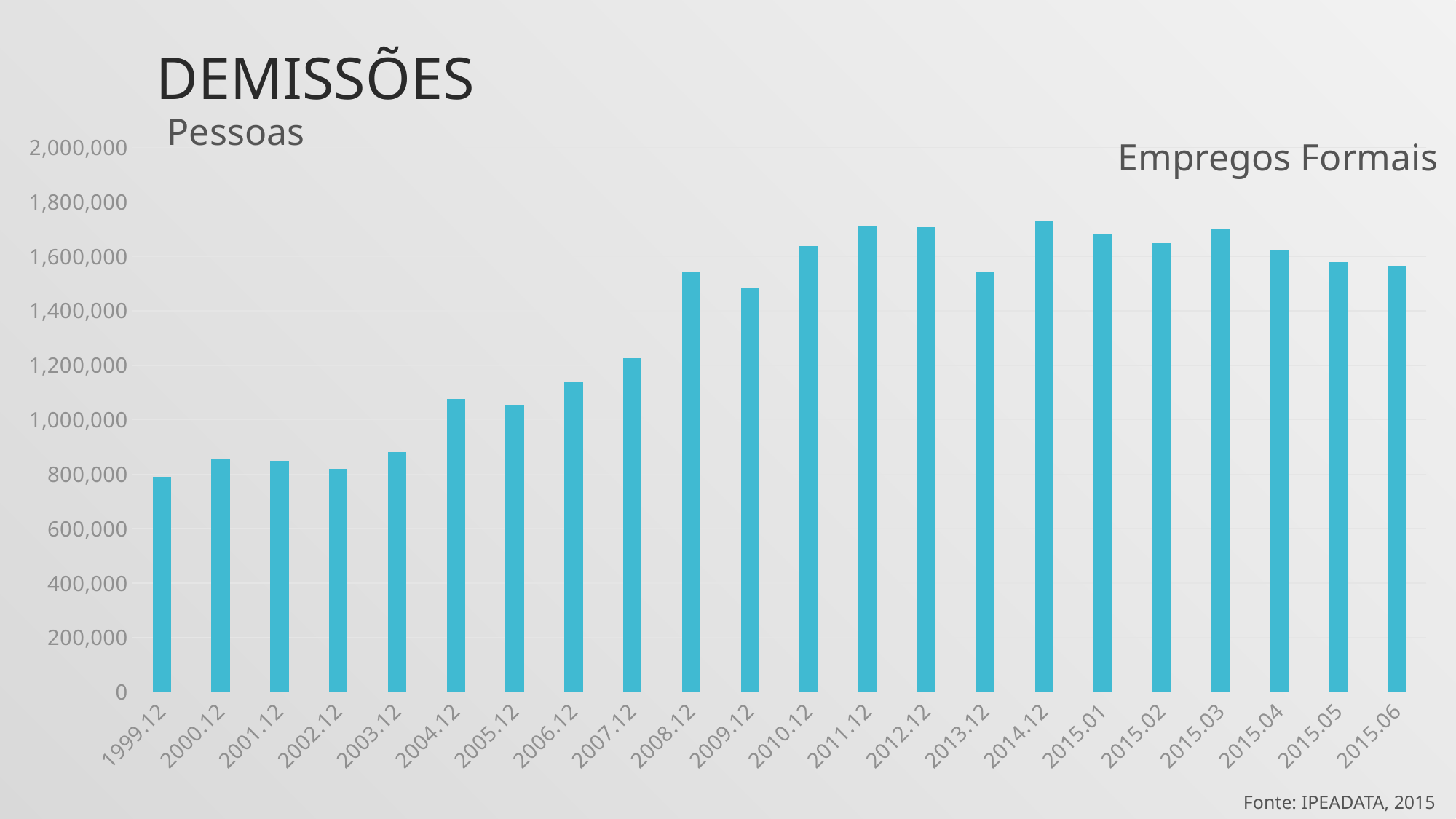
How many bars (time periods) are plotted in the chart? 22 Is the value for 2003.12 greater or less than 1,000,000? less Which is larger, the value for 2008.12 or the value for 2009.12? 2008.12 What kind of chart is shown on the slide? bar chart Is the value for 2007.12 greater or less than 1,400,000? less Is the value for 2014.12 greater or less than 1,600,000? greater What is the title of the chart? DEMISSÕES Do the values generally rise or fall from 1999.12 to 2008.12? rise Which is larger, the value for 2010.12 or the value for 2013.12? 2010.12 Which period has the lowest value in the chart? 1999.12